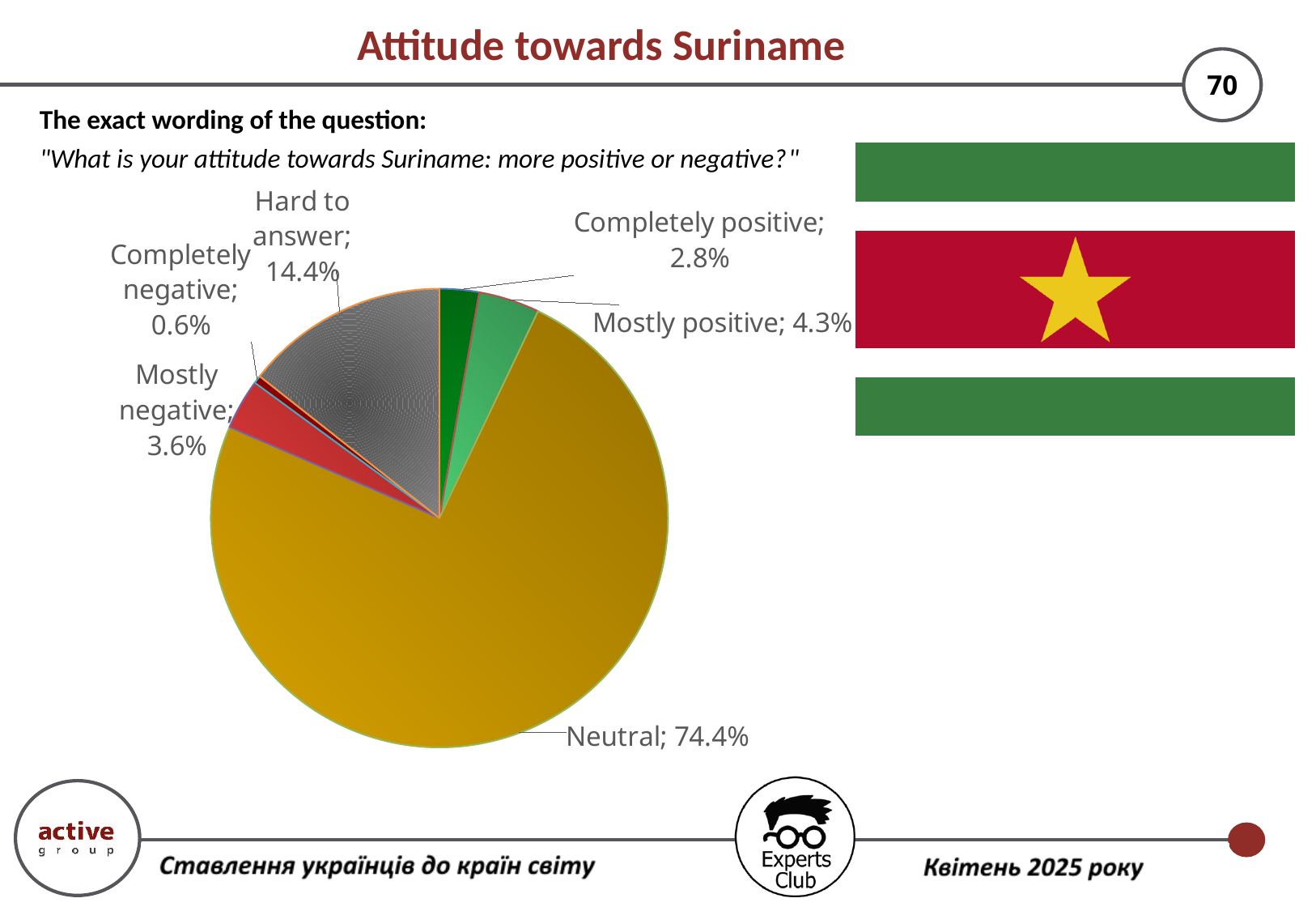
What is the title of the slide? Attitude towards Suriname What share of respondents answered "Hard to answer"? 14.4% Which is larger: the share for "Mostly negative" or the share for "Completely positive"? Mostly negative What share of respondents answered "Mostly positive"? 4.3% Which response category has the largest slice of the pie? Neutral What share of respondents answered "Completely negative"? 0.6% What kind of chart is shown on the slide? Pie chart What is the combined share of "Completely positive" and "Mostly positive" responses? 7.1% How many response categories are shown in the pie chart? 6 What is the difference between the "Mostly positive" and "Completely positive" shares? 1.5% Which response category has the smallest slice of the pie? Completely negative What share of respondents answered "Neutral"? 74.4%